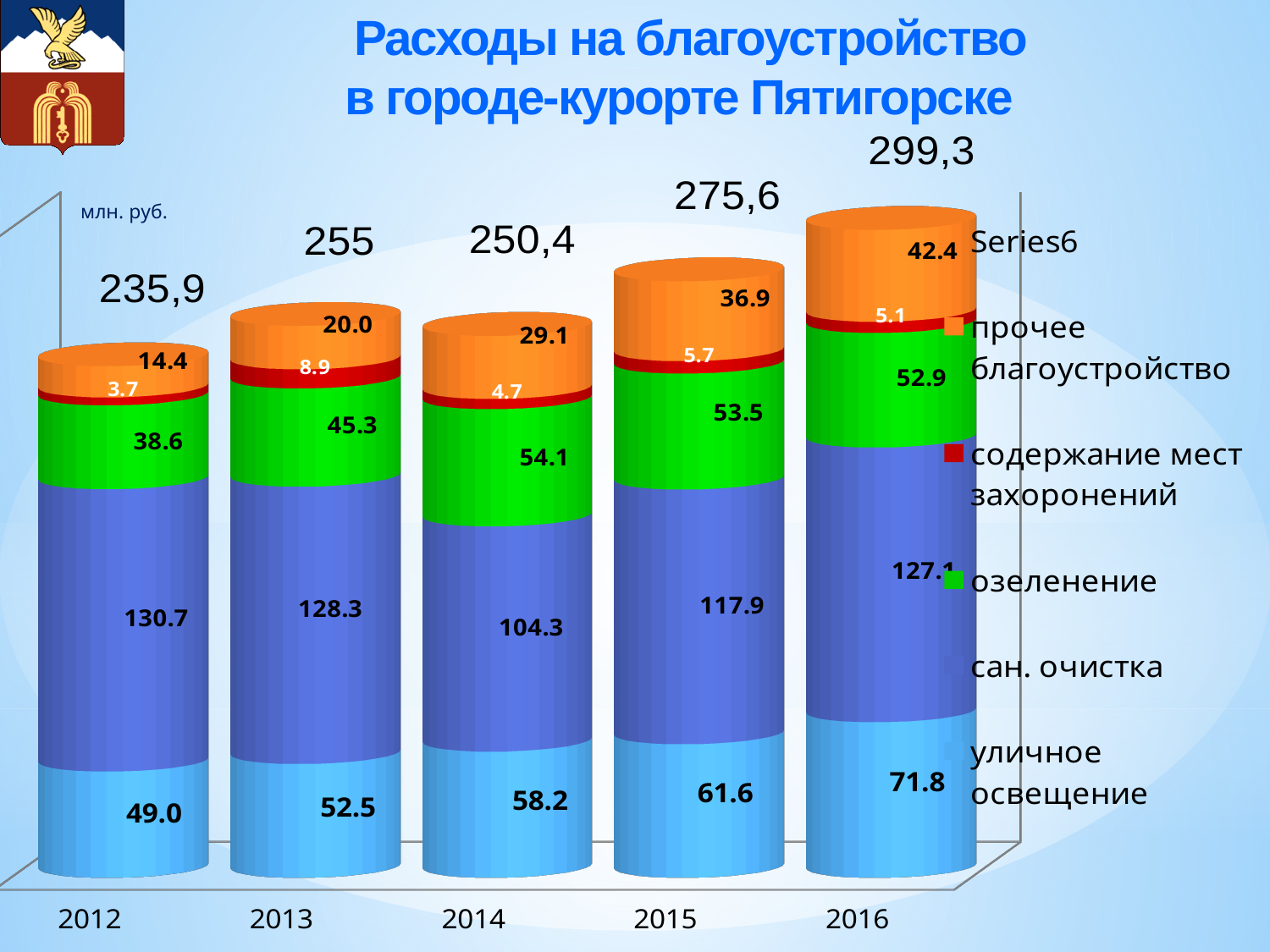
What is the difference between the прочее благоустройство values for 2016 and 2012? 28.0 What is the total of the stacked bar for 2016? 299,3 How many years are shown on the x axis? 5 What is the value for прочее благоустройство in 2013? 20.0 What kind of chart is shown on the slide? stacked bar chart What is the difference between the уличное освещение values for 2016 and 2012? 22.8 What is the value for уличное освещение in 2016? 71.8 Which is larger, the сан. очистка value for 2012 or for 2014? 2012 What is the value for сан. очистка in 2014? 104.3 Which year has the highest total expenditure? 2016 Which year has the lowest total expenditure? 2012 Do the уличное освещение values rise or fall from 2012 to 2016? rise